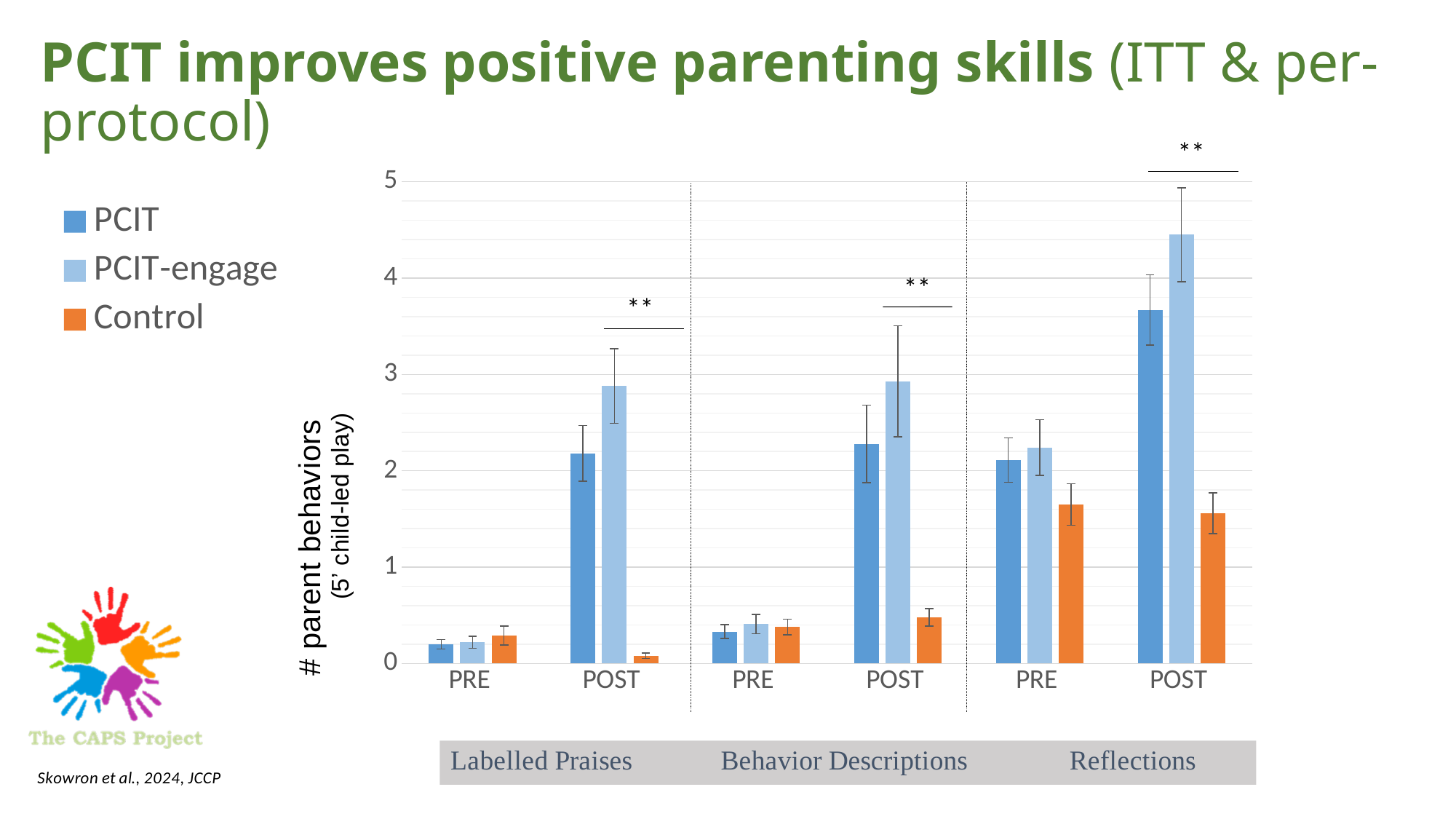
What is the label on the y axis of the chart? # parent behaviors (5' child-led play) Is the value for Control at POST in the Labelled Praises panel greater or less than 1? less How many series does the legend list? 3 Which series has the highest value at POST in the Reflections panel? PCIT-engage In the Labelled Praises panel, does the PCIT value rise or fall from PRE to POST? rise Is the value for PCIT at POST in the Behavior Descriptions panel greater or less than 2? greater What are the three series named in the legend? PCIT, PCIT-engage, Control Is the value for PCIT-engage at POST in the Reflections panel greater or less than 4? greater Which series has the lowest value at POST in the Behavior Descriptions panel? Control What kind of chart is shown on the slide? bar chart At POST in the Labelled Praises panel, which is larger: PCIT-engage or Control? PCIT-engage How many outcome panels (skill categories) are shown along the bottom of the chart? 3